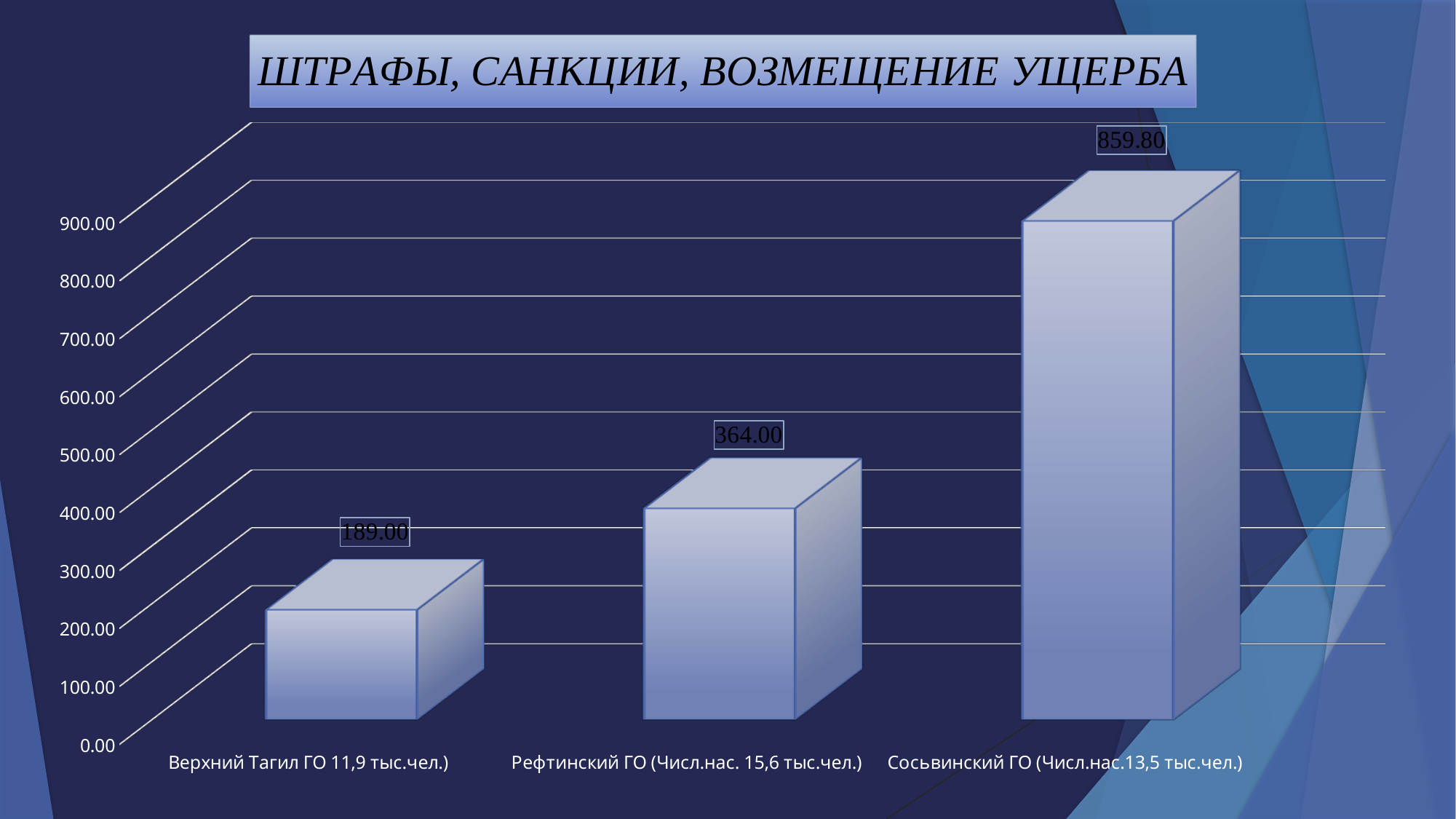
What kind of chart is shown on the slide? bar chart Is the value for Сосьвинский ГО greater or less than 800.00? greater Which category has the highest value? Сосьвинский ГО (Числ.нас.13,5 тыс.чел.) What is the value for Верхний Тагил ГО (11,9 тыс.чел.)? 189.00 What is the difference between the values for Рефтинский ГО and Верхний Тагил ГО? 175.00 What is the difference between the values for Сосьвинский ГО and Рефтинский ГО? 495.80 What is the value for Рефтинский ГО (Числ.нас. 15,6 тыс.чел.)? 364.00 How many categories are shown on the chart? 3 What is the title of the chart? ШТРАФЫ, САНКЦИИ, ВОЗМЕЩЕНИЕ УЩЕРБА Which is larger, the value for Рефтинский ГО or the value for Верхний Тагил ГО? Рефтинский ГО What is the value for Сосьвинский ГО (Числ.нас.13,5 тыс.чел.)? 859.80 Which category has the lowest value? Верхний Тагил ГО 11,9 тыс.чел.